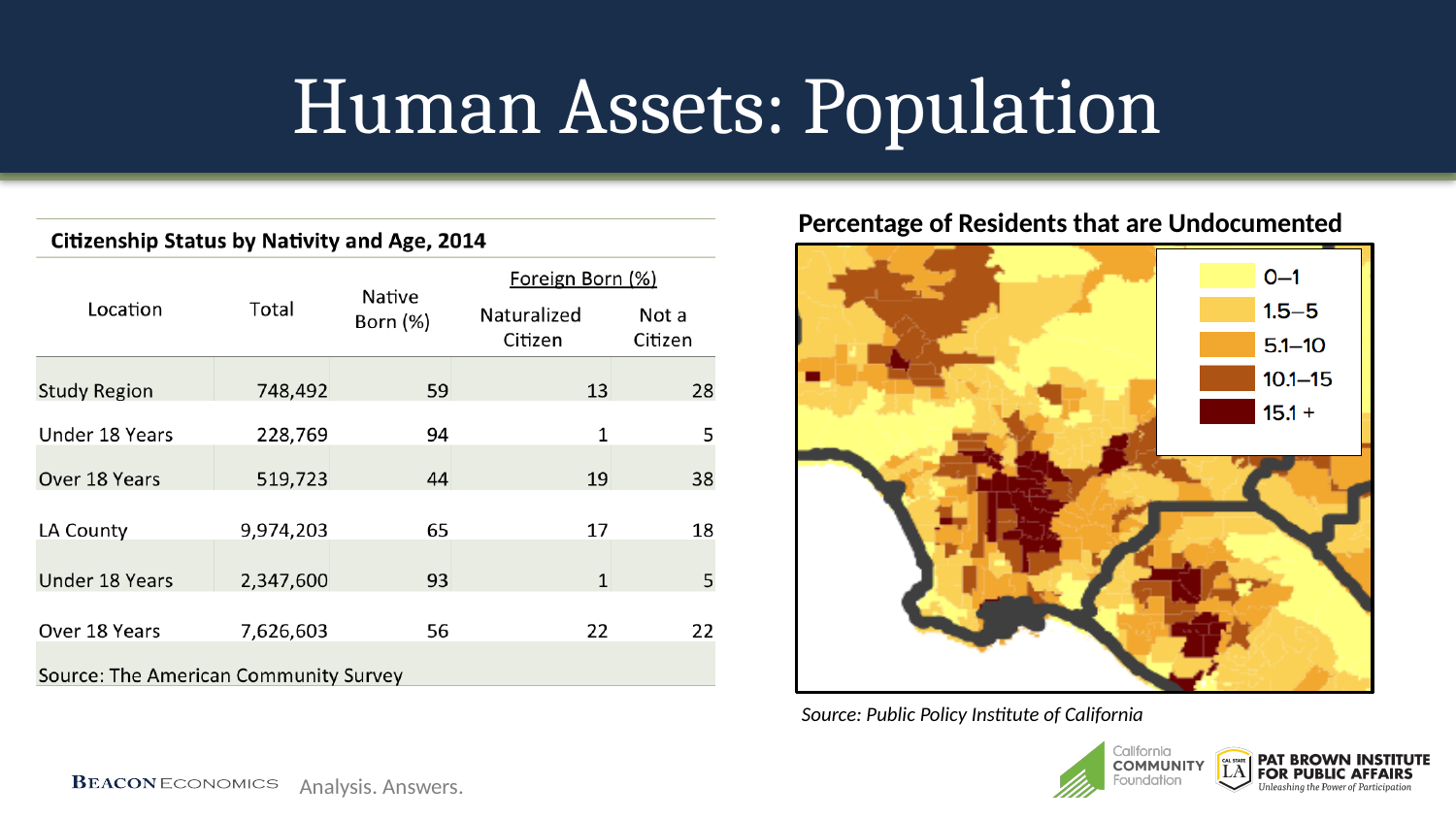
What kind of chart is shown on the right side of the slide under 'Percentage of Residents that are Undocumented'? A map (choropleth map) In the 'Percentage of Residents that are Undocumented' map, which legend category is shown in the darkest colour? 15.1 + In the 'Percentage of Residents that are Undocumented' map, what range does the lightest (yellow) legend colour represent? 0–1 What is the title of the map on the right side of the slide? Percentage of Residents that are Undocumented In the 'Percentage of Residents that are Undocumented' map, what range does the legend category between '5.1–10' and '15.1 +' represent? 10.1–15 How many categories does the legend of the 'Percentage of Residents that are Undocumented' map list? 5